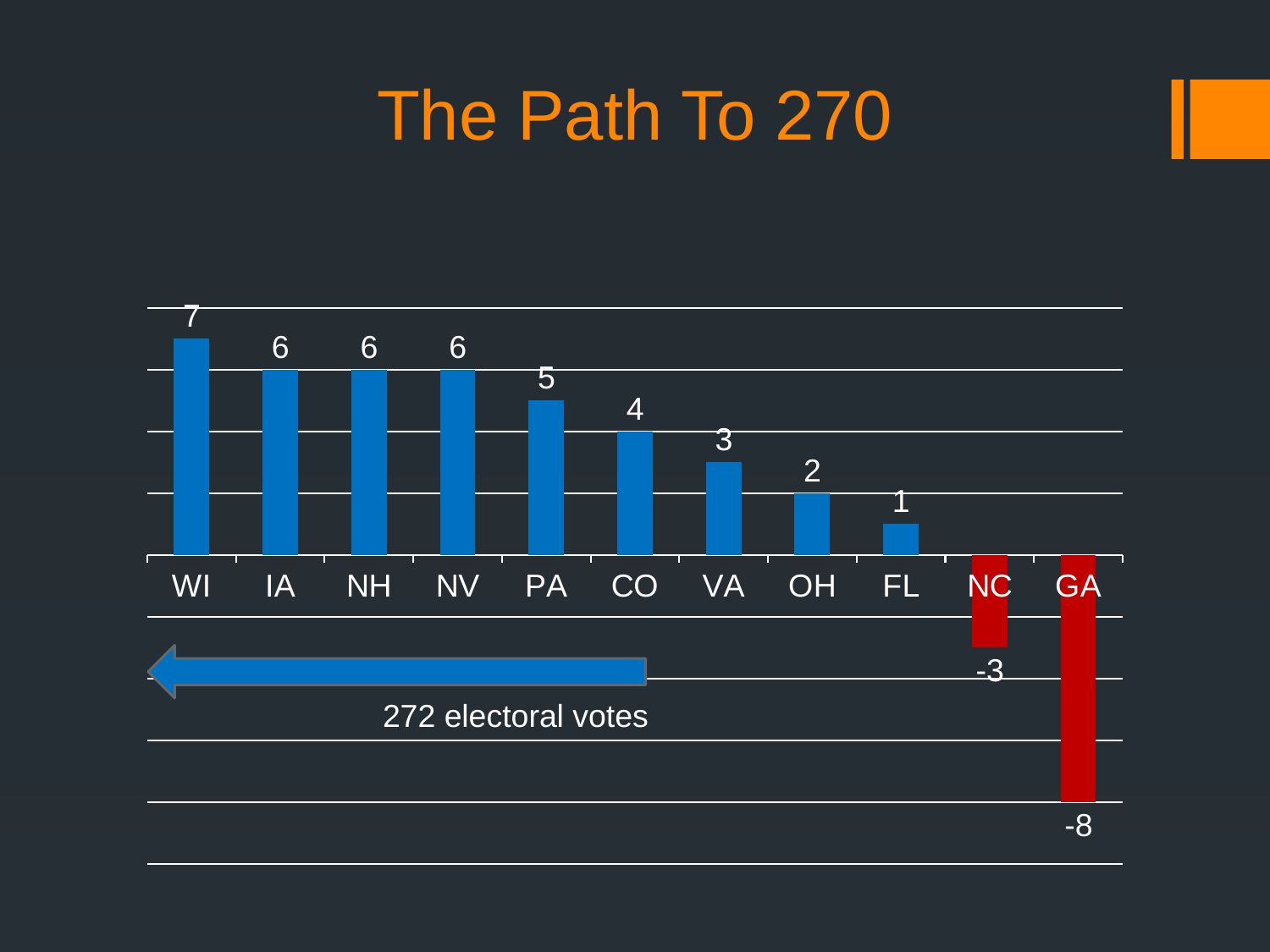
Which category has the lowest value? GA What is the value for GA? -8 Which category has the highest value? WI What is the value for NC? -3 What is the title of the slide? The Path To 270 What is the value for PA? 5 How many categories are shown on the x axis? 11 What is the difference between the values for WI and CO? 3 What kind of chart is shown? bar chart What is the value for WI? 7 Do the values rise or fall from WI to GA along the x axis? fall Which is larger, the value for VA or the value for OH? VA